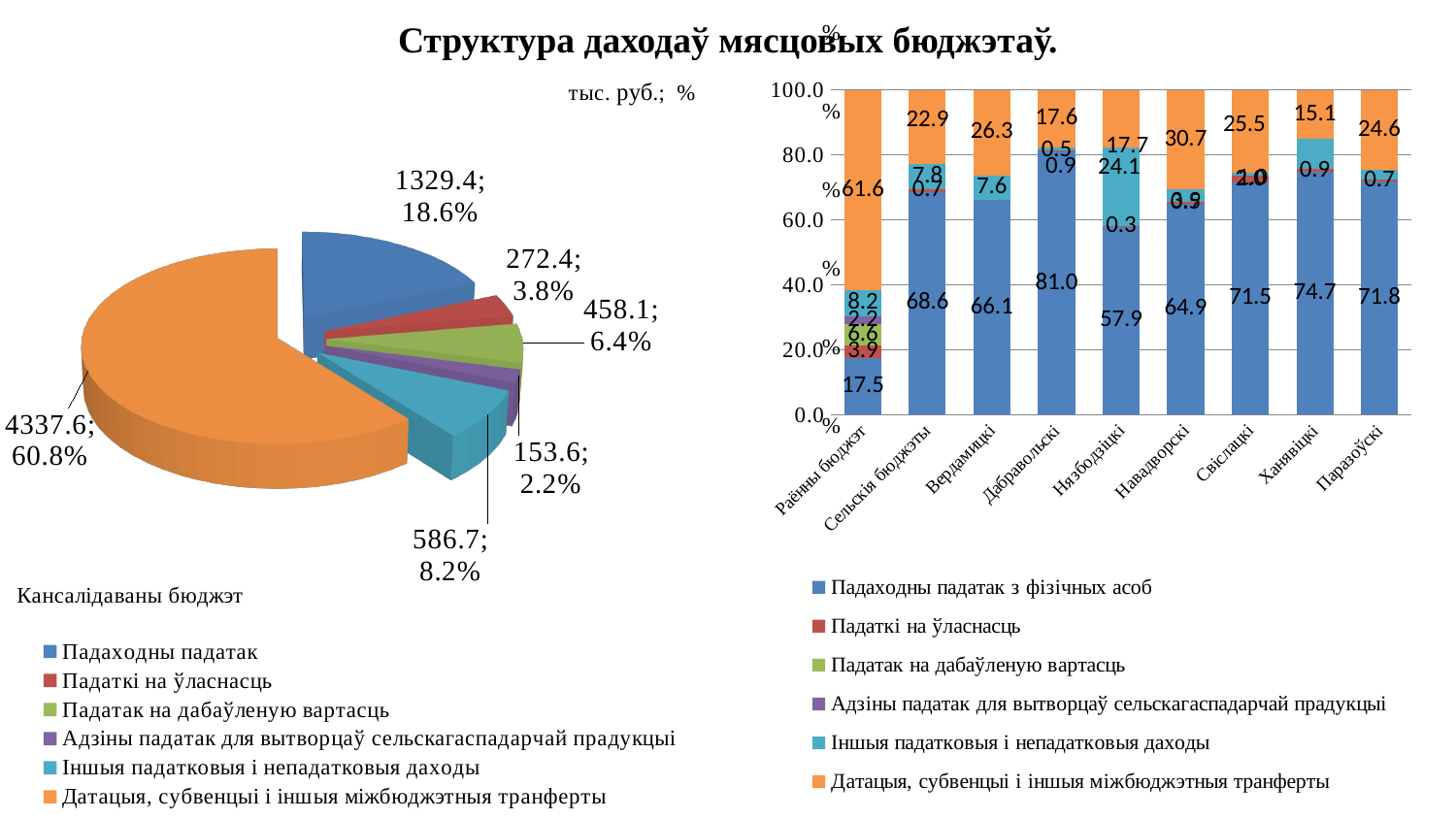
On the pie chart (Кансалідаваны бюджэт), what is the value shown for Іншыя падатковыя і непадатковыя даходы? 586.7; 8.2% On the pie chart (Кансалідаваны бюджэт), what value and share are shown for Датацыі, субвенцыі і іншыя міжбюджэтныя трансферты? 4337.6; 60.8% On the stacked bar chart on the right, what is the value of Падаходны падатак з фізічных асоб for Дабравольскі? 81.0 On the pie chart (Кансалідаваны бюджэт), what is the difference between the values for Падаходны падатак and Падатак на дабаўленую вартасць? 871.3 On the stacked bar chart on the right, what is the value of Датацыі, субвенцыі і іншыя міжбюджэтныя трансферты for Раённы бюджэт? 61.6 On the pie chart (Кансалідаваны бюджэт), what share does Падаходны падатак have? 18.6% On the stacked bar chart on the right, which category has the highest value for Падаходны падатак з фізічных асоб? Дабравольскі On the stacked bar chart on the right, how many series does the legend list? 6 What type of chart is shown on the right side of the slide? Stacked bar chart On the pie chart (Кансалідаваны бюджэт), which category has the smallest slice? Адзіны падатак для вытворцаў сельскагаспадарчай прадукцыі On the stacked bar chart on the right, how many categories are shown on the x axis? 9 On the pie chart (Кансалідаваны бюджэт), which is larger: Падаткі на ўласнасць or Падатак на дабаўленую вартасць? Падатак на дабаўленую вартасць